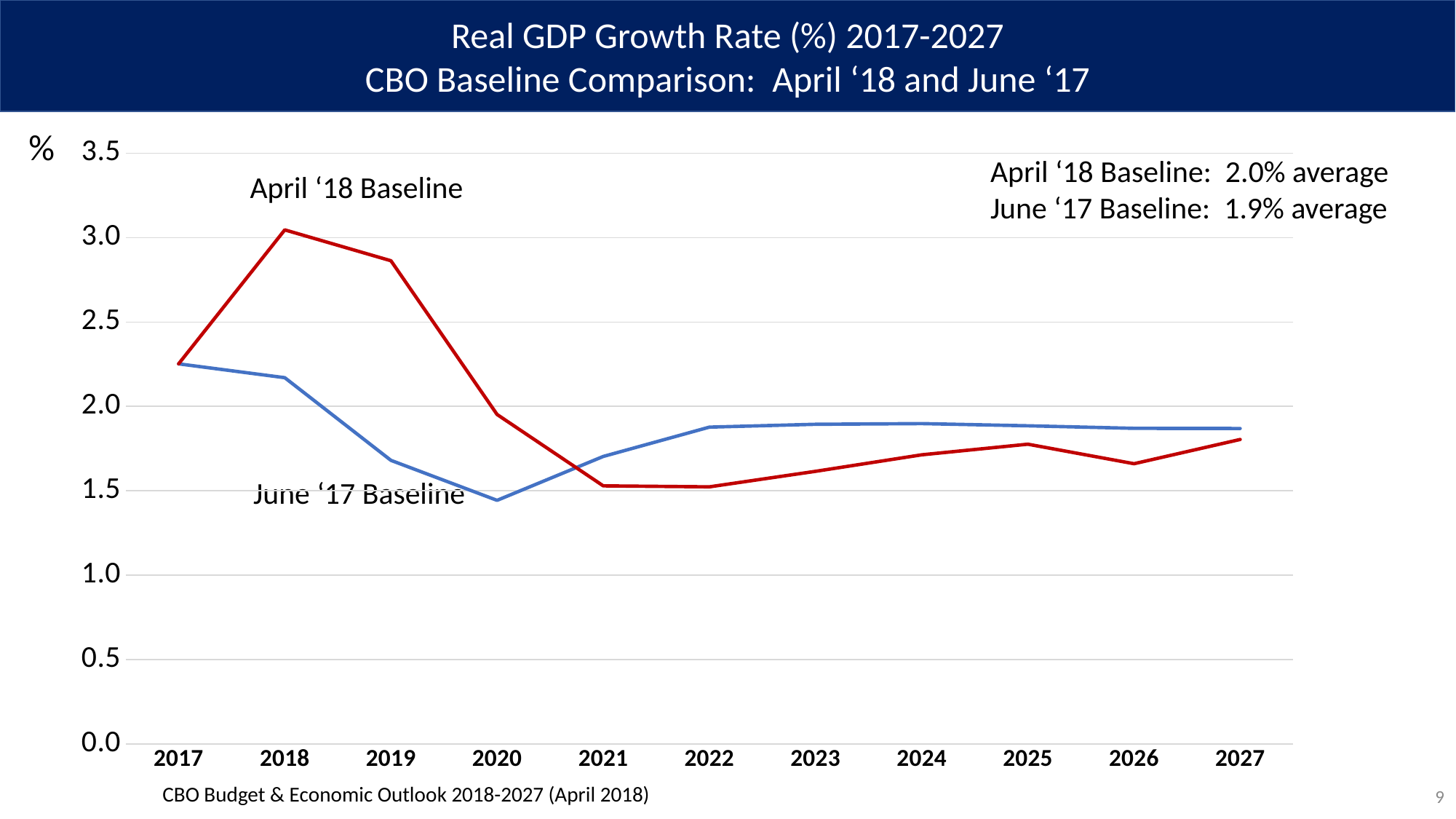
Is the June '17 Baseline value for 2020 greater or less than 2.0? less In which year does the June '17 Baseline reach its highest value? 2017 What kind of chart is shown on the slide? Line chart How many years are plotted along the x axis? 11 Is the April '18 Baseline value for 2018 greater or less than 2.5? greater In which year does the April '18 Baseline reach its highest value? 2018 How many series (baselines) are plotted on the chart? 2 In 2018, which baseline has the higher value, April '18 or June '17? April '18 Baseline In 2022, which baseline has the higher value, April '18 or June '17? June '17 Baseline Is the April '18 Baseline value for 2021 greater or less than 2.0? less In which year does the June '17 Baseline reach its lowest value? 2020 Does the April '18 Baseline rise or fall from 2018 to 2021? Fall